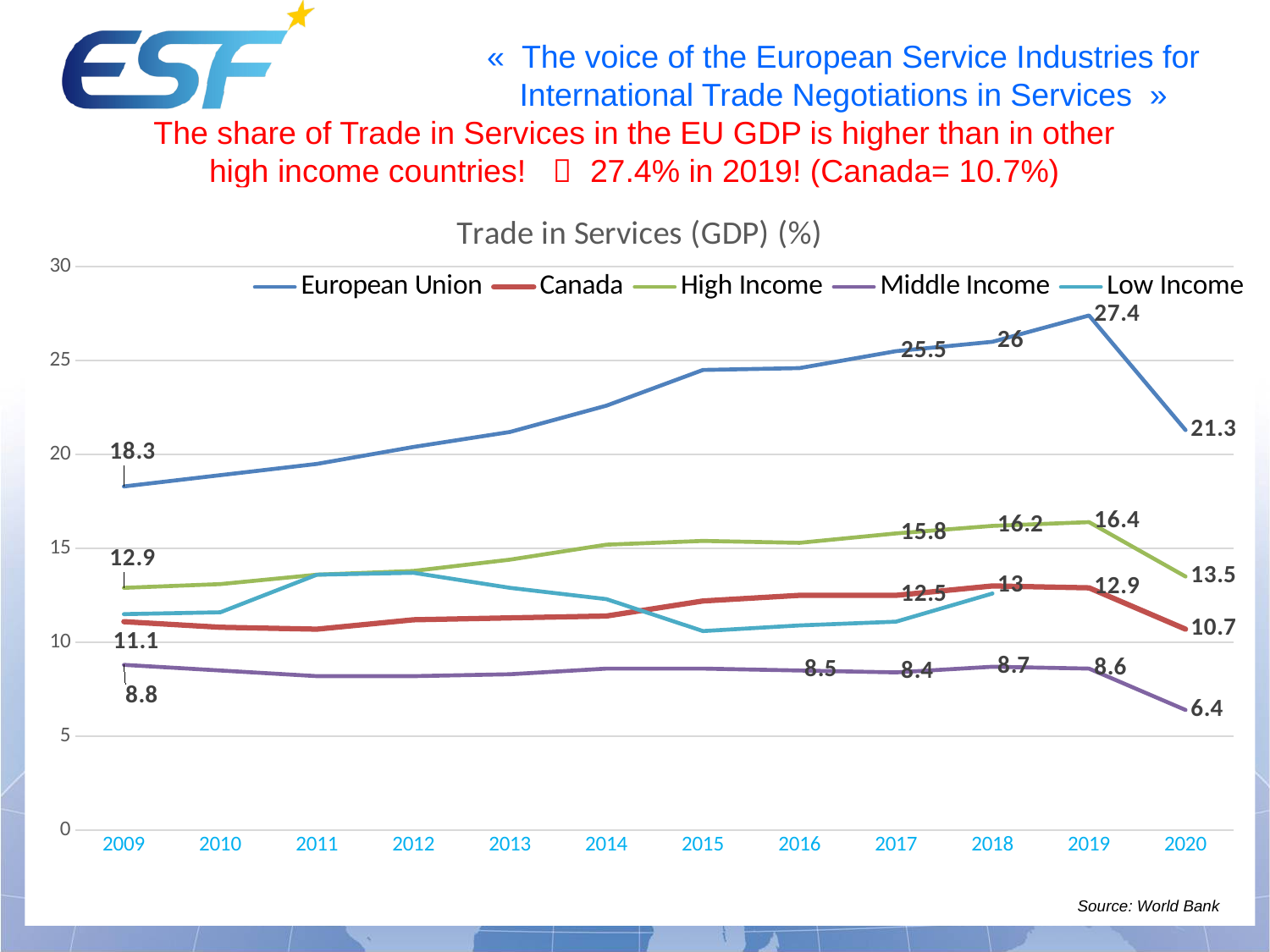
By how much did the European Union value fall from 2019 to 2020? 6.1 What is the value for High Income in 2018? 16.2 How many years are shown on the x axis? 12 What kind of chart is shown on the slide? Line chart What is the value for Middle Income in 2020? 6.4 Which is larger in 2019, the High Income value or the Canada value? High Income What is the value for the European Union in 2019? 27.4 How many series does the legend list? 5 Which series has the lowest value in 2020? Middle Income What is the value for Canada in 2020? 10.7 Is the value for the European Union in 2014 greater or less than 20? greater Which series has the highest value in 2019? European Union